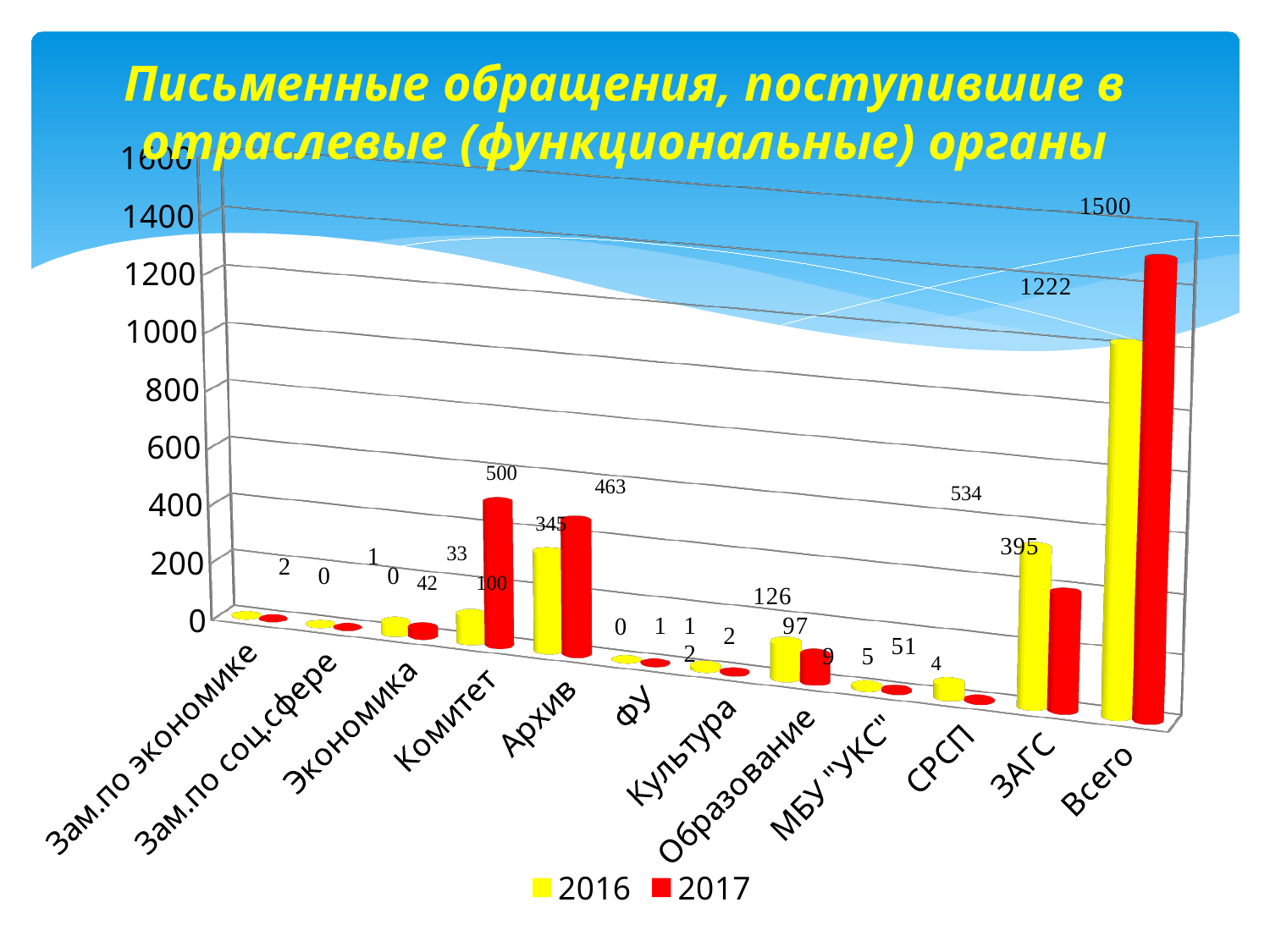
What is the 2017 value for Всего? 1500 What is the 2016 value for Архив? 345 What is the difference between the 2017 and 2016 values for Всего? 278 Excluding Всего, which category has the highest 2017 value? Комитет What is the 2016 value for Всего? 1222 What is the 2016 value for ЗАГС? 534 Which colour represents the 2017 series in the legend? red How many categories are shown on the x axis? 12 What is the 2017 value for Комитет? 500 What type of chart is shown on the slide? bar chart How many series does the legend list? 2 Which is larger for Образование: the 2016 value or the 2017 value? 2016